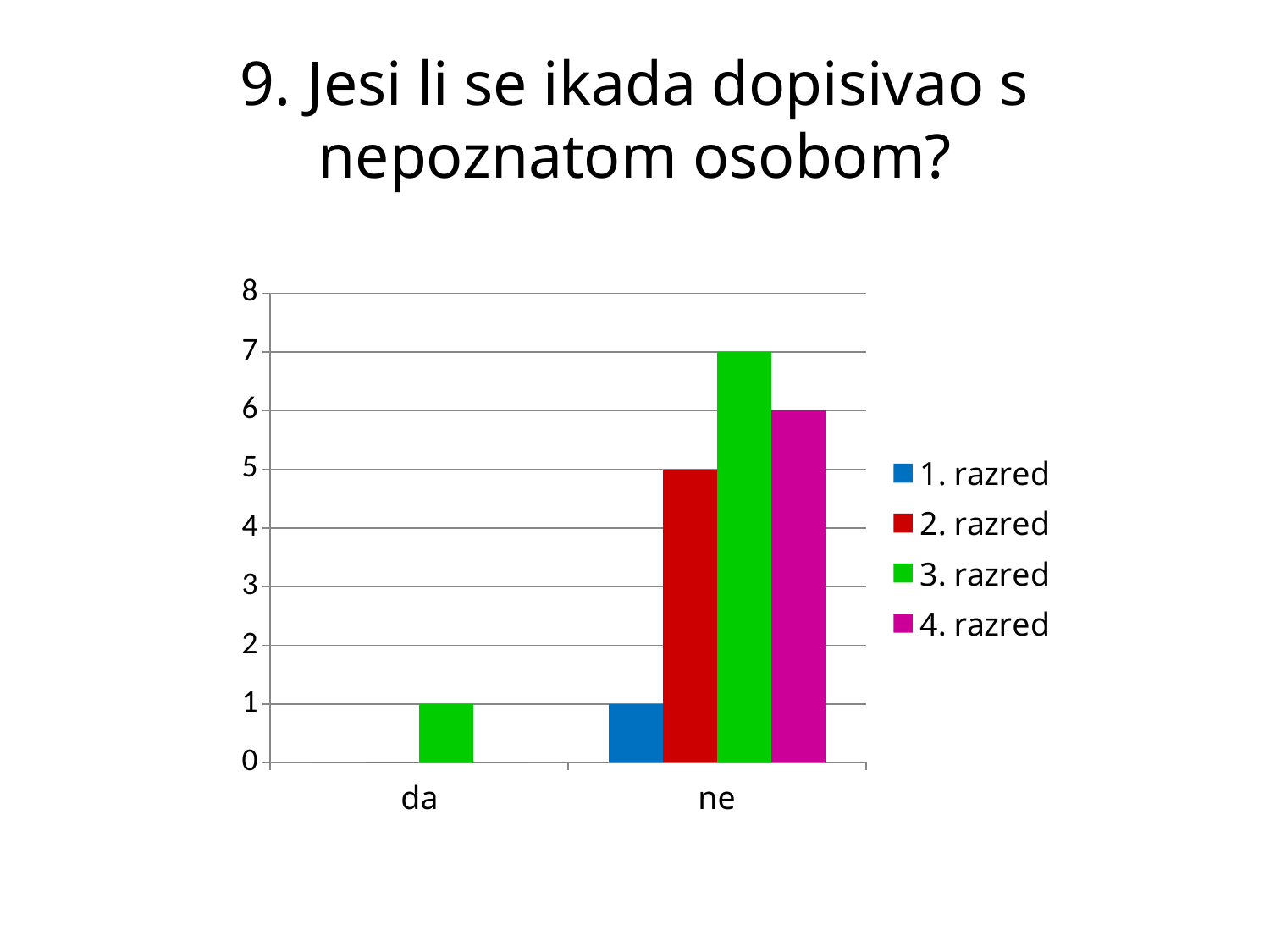
What is the value for 4. razred in the "ne" category? 6 What is the value for 2. razred in the "ne" category? 5 Which series has the lowest value in the "ne" category? 1. razred How many categories are shown on the x axis? 2 Which is larger in the "ne" category: the value for 4. razred or the value for 2. razred? 4. razred Which series has the highest value in the "ne" category? 3. razred What is the value for 3. razred in the "da" category? 1 What is the value for 1. razred in the "ne" category? 1 What is the value for 3. razred in the "ne" category? 7 What kind of chart is shown on the slide? bar chart What is the difference between the values for 3. razred and 2. razred in the "ne" category? 2 How many series does the legend list? 4